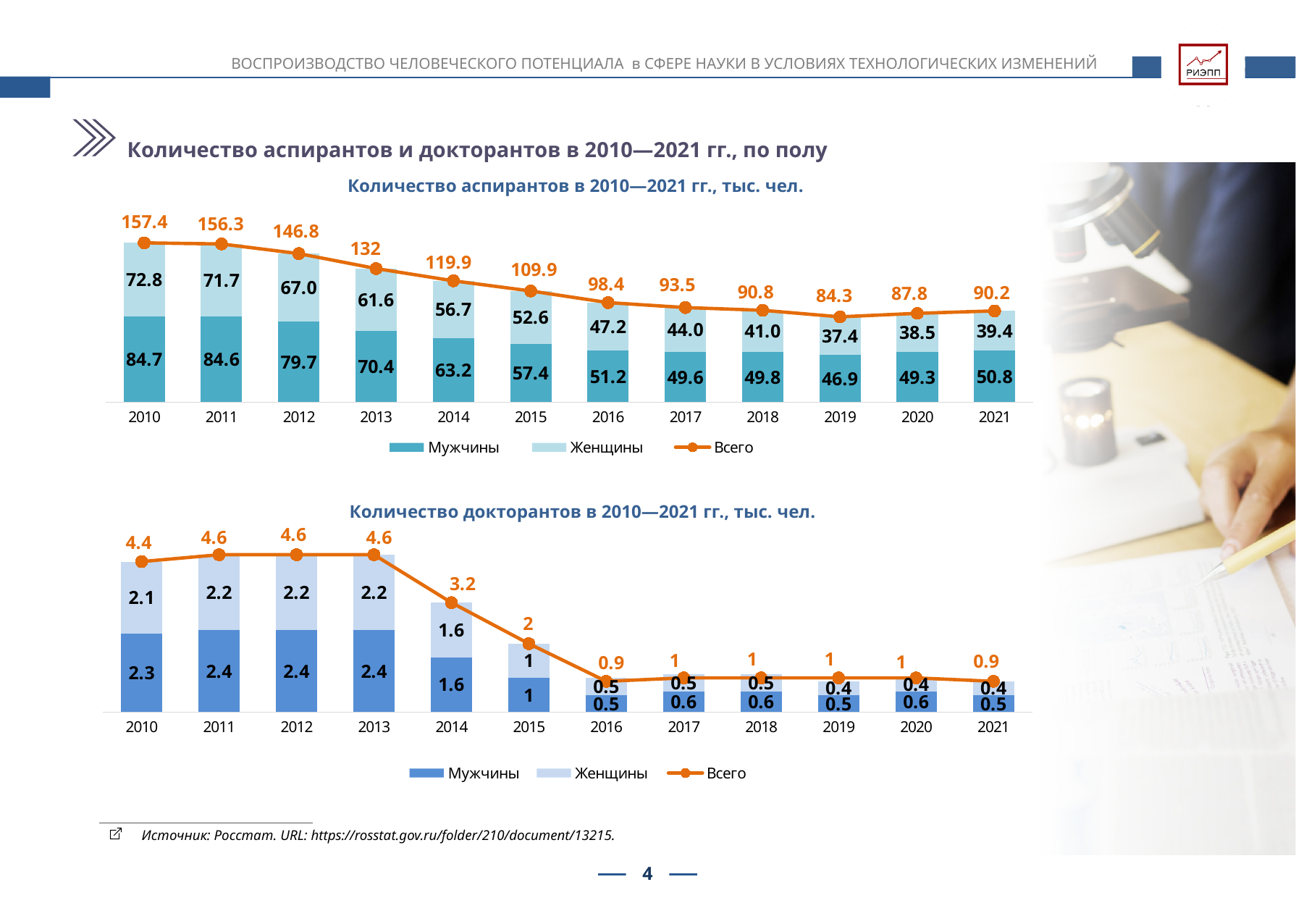
In the chart 'Количество аспирантов в 2010—2021 гг., тыс. чел.', how many series does the legend list? 3 In the chart 'Количество аспирантов в 2010—2021 гг., тыс. чел.', what is the difference between the Мужчины values for 2010 and 2021? 33.9 In the chart 'Количество аспирантов в 2010—2021 гг., тыс. чел.', which year has the highest Всего value? 2010 In the chart 'Количество аспирантов в 2010—2021 гг., тыс. чел.', what is the value for Мужчины in 2010? 84.7 In the chart 'Количество докторантов в 2010—2021 гг., тыс. чел.', what is the Всего value for 2015? 2 In the chart 'Количество аспирантов в 2010—2021 гг., тыс. чел.', what is the value for Женщины in 2015? 52.6 What kind of chart is 'Количество докторантов в 2010—2021 гг., тыс. чел.'? Stacked bar chart with a line In the chart 'Количество аспирантов в 2010—2021 гг., тыс. чел.', which year has the lowest Всего value? 2019 In the chart 'Количество аспирантов в 2010—2021 гг., тыс. чел.', what is the Всего value for 2019? 84.3 In the chart 'Количество докторантов в 2010—2021 гг., тыс. чел.', is the Мужчины value for 2011 larger or smaller than the Мужчины value for 2016? larger In the chart 'Количество докторантов в 2010—2021 гг., тыс. чел.', how many years are shown on the x axis? 12 In the chart 'Количество докторантов в 2010—2021 гг., тыс. чел.', what is the value for Женщины in 2014? 1.6